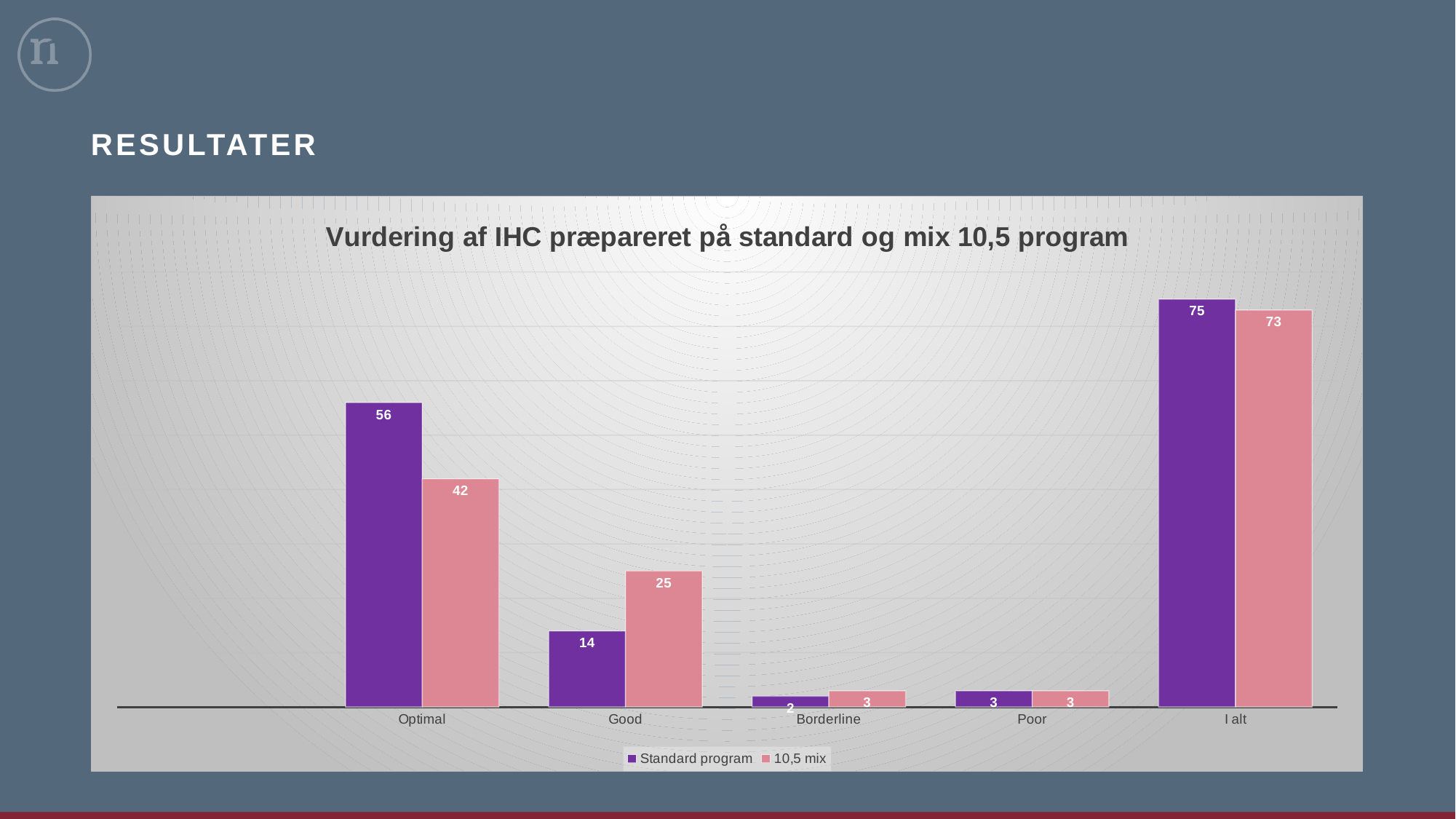
What is the value for 10,5 mix in the Good category? 25 Which series has the larger value in the Good category, Standard program or 10,5 mix? 10,5 mix Which category has the highest value for the 10,5 mix series? I alt What is the value for Standard program in the I alt category? 75 Which category has the lowest value for the Standard program series? Borderline How many series does the legend list? 2 What is the value for 10,5 mix in the Borderline category? 3 What kind of chart is shown on the slide? Bar chart What is the difference between Standard program and 10,5 mix in the Optimal category? 14 What is the title of the chart? Vurdering af IHC præpareret på standard og mix 10,5 program What is the value for Standard program in the Optimal category? 56 How many categories are shown on the x axis? 5